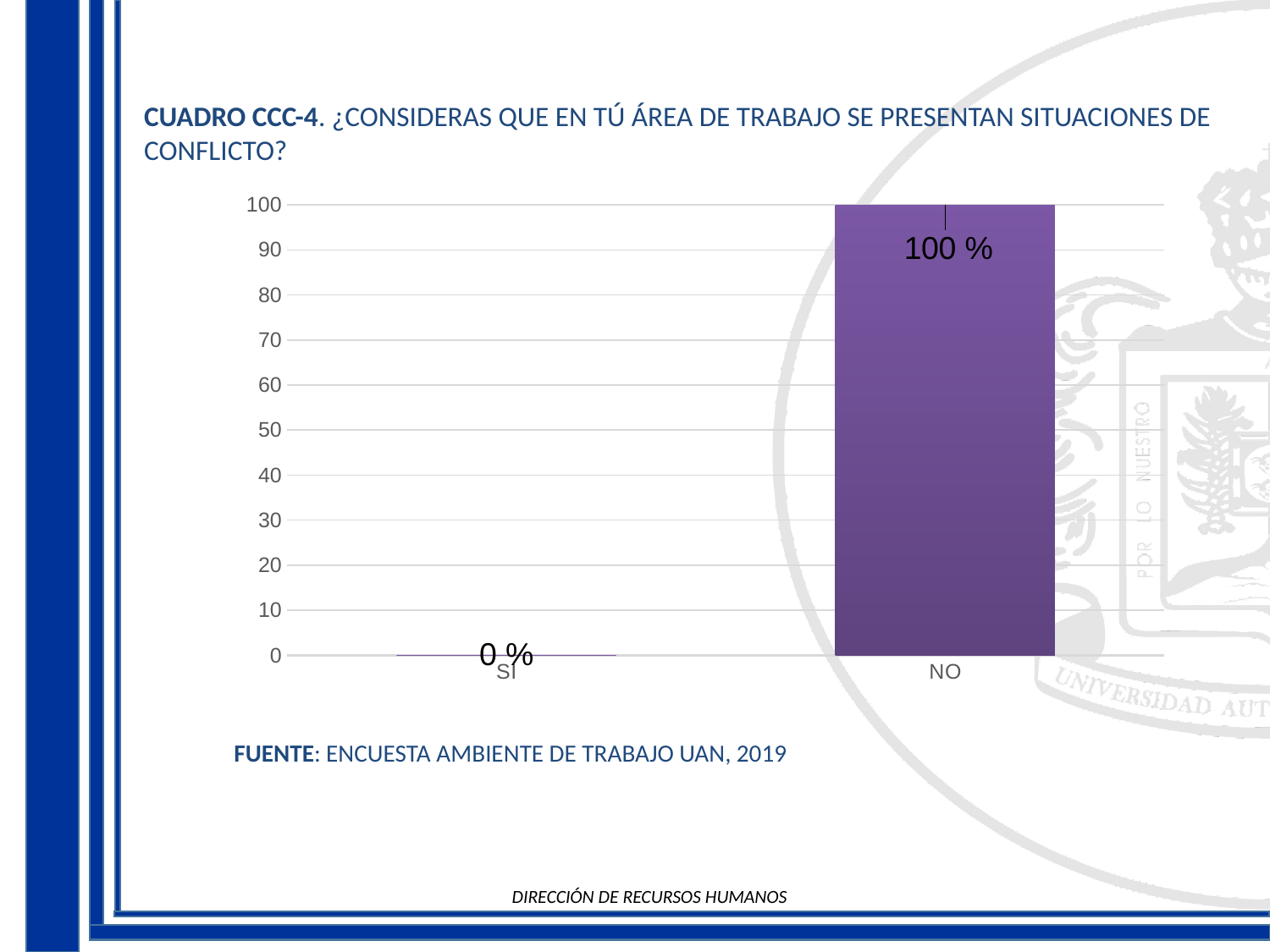
What is the value for SI? 0 % What is the maximum value shown on the vertical axis? 100 Which category has the lowest value? SI What kind of chart is shown on the slide? bar chart How many categories are shown on the x axis? 2 What source is cited below the chart? ENCUESTA AMBIENTE DE TRABAJO UAN, 2019 Which category has the highest value? NO What is the value for NO? 100 % What is the difference between the values for NO and SI? 100 % Is the value for NO greater or less than 50? greater Which is larger, the value for SI or the value for NO? NO